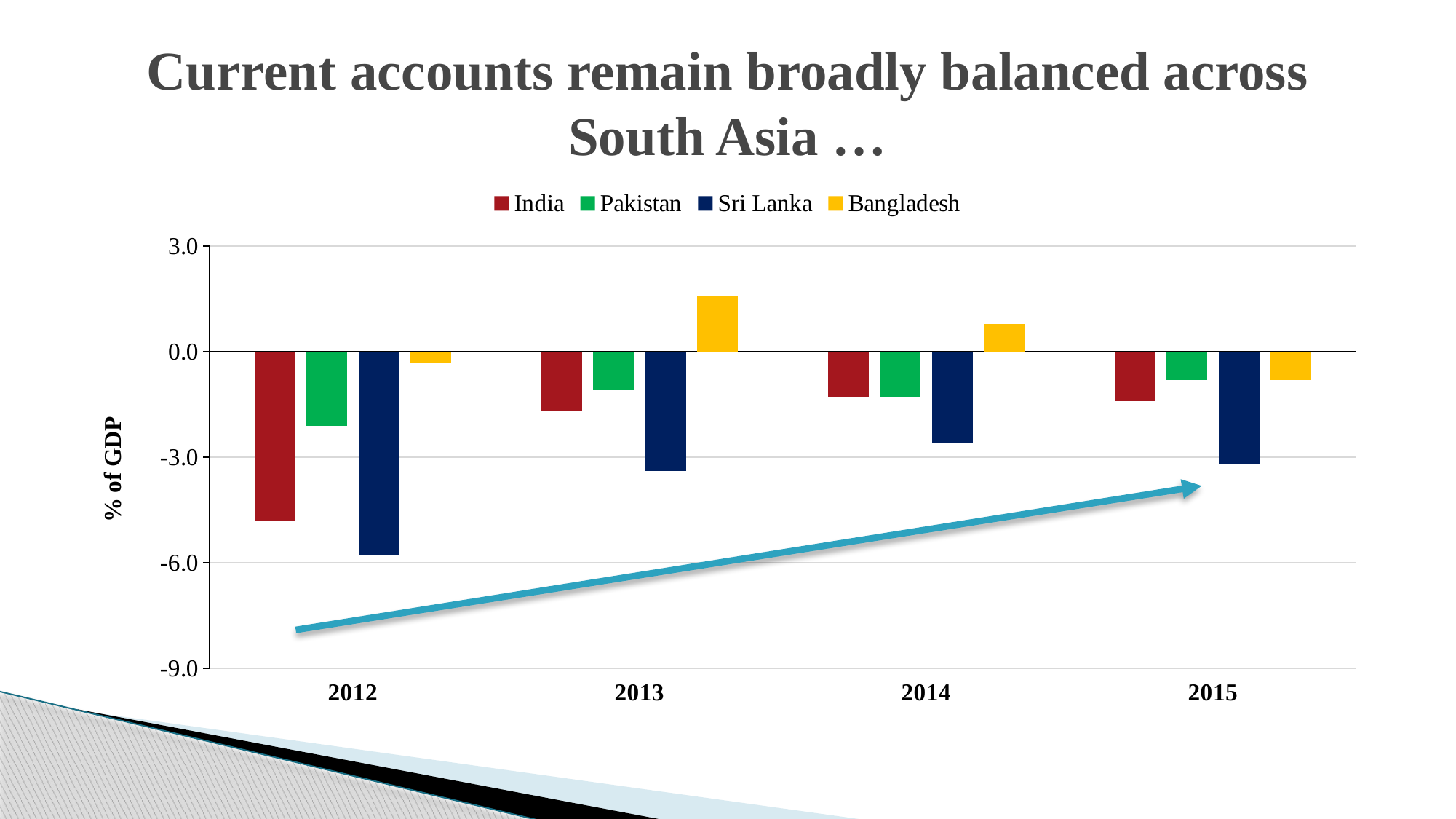
What kind of chart is shown on the slide? bar chart Which country has the lowest value in 2012? Sri Lanka Which country has the highest value in 2013? Bangladesh How many series does the legend list? 4 Which is larger, the value for India in 2012 or the value for India in 2015? India in 2015 What is the label on the vertical axis? % of GDP Is the value for Sri Lanka in 2012 greater or less than -3.0? less How many years are shown on the x axis? 4 Is the value for Bangladesh in 2013 greater or less than 0.0? greater Does the value for Sri Lanka rise or fall from 2012 to 2014? rise Is the value for India in 2015 greater or less than -3.0? greater